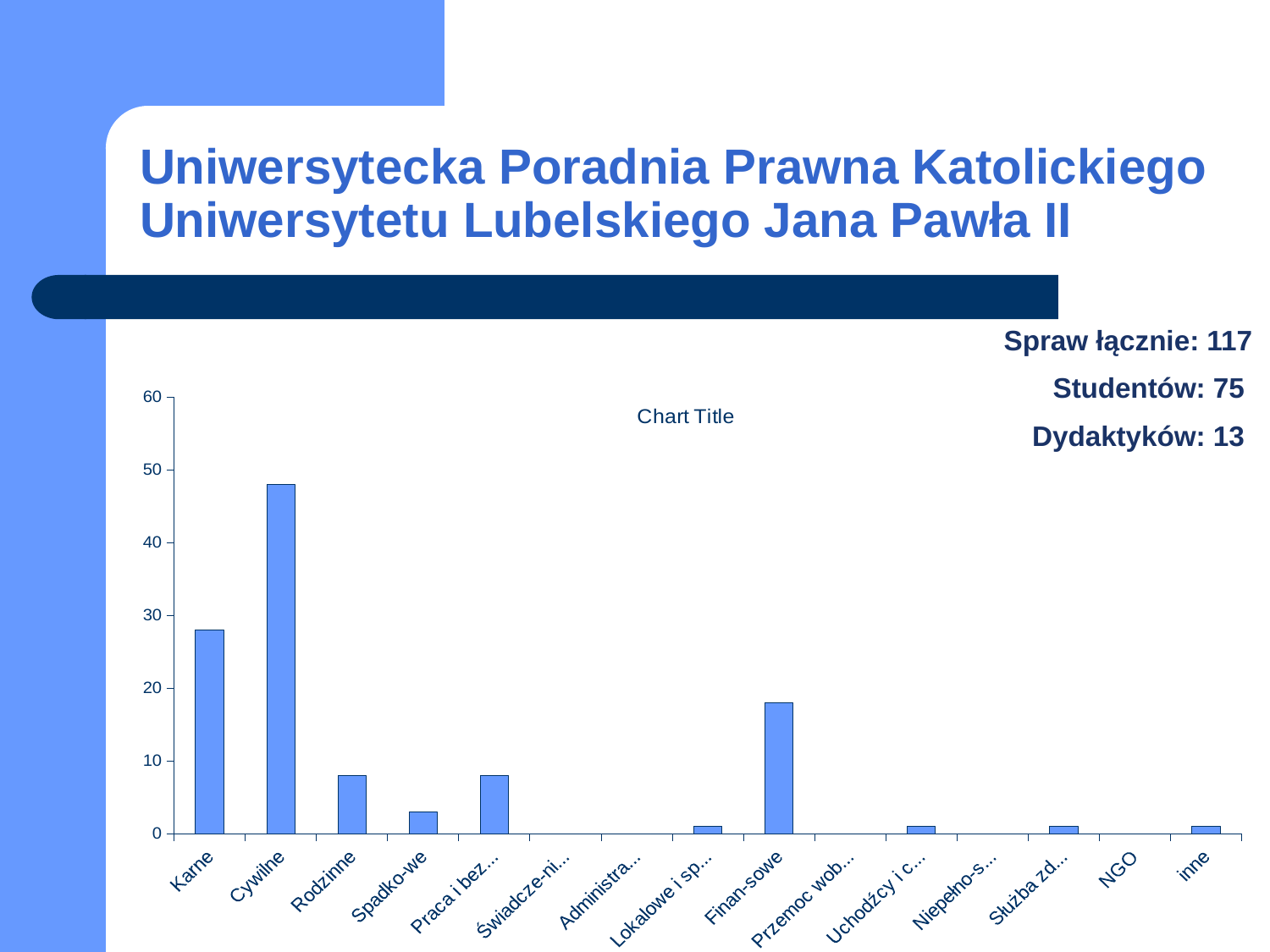
Is the value for Cywilne greater or less than 40? greater Which is larger, the value for Cywilne or the value for Karne? Cywilne Which category has the highest bar in the chart? Cywilne Is the value for Finan-sowe greater or less than 20? less Is the value for Karne greater or less than 20? greater What kind of chart is shown on the slide? bar chart What title is displayed on the chart? Chart Title How many categories are shown on the x axis of the chart? 15 Which is larger, the value for Karne or the value for Finan-sowe? Karne Which is larger, the value for Rodzinne or the value for Spadko-we? Rodzinne